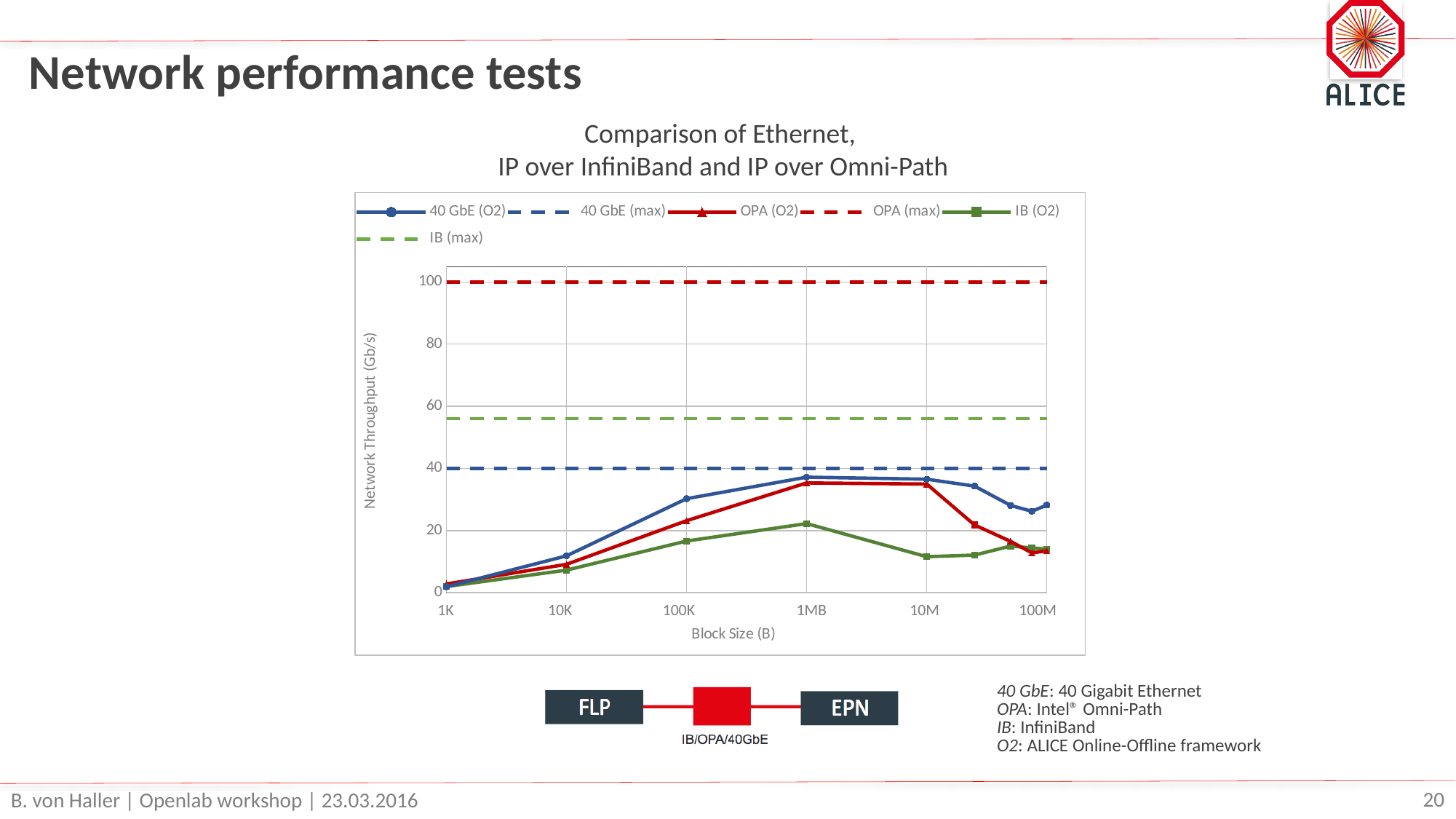
Is the value for 40 GbE (O2) at block size 1MB greater or less than 20? greater What kind of chart is shown on the slide? line chart Which series has the highest value on the chart? OPA (max) How many series does the chart legend list? 6 Does the OPA (O2) line rise or fall from block size 1MB to 100M? fall How many block size labels are shown on the x axis? 6 At block size 100M, which is higher: 40 GbE (O2) or OPA (O2)? 40 GbE (O2) At block size 1MB, which is higher: 40 GbE (O2) or IB (O2)? 40 GbE (O2) Is the value for OPA (O2) at block size 100M greater or less than 20? less What is the label of the y axis? Network Throughput (Gb/s) What is the value of the OPA (max) line in Gb/s? 100 Is the value for IB (O2) at block size 10M greater or less than 20? less